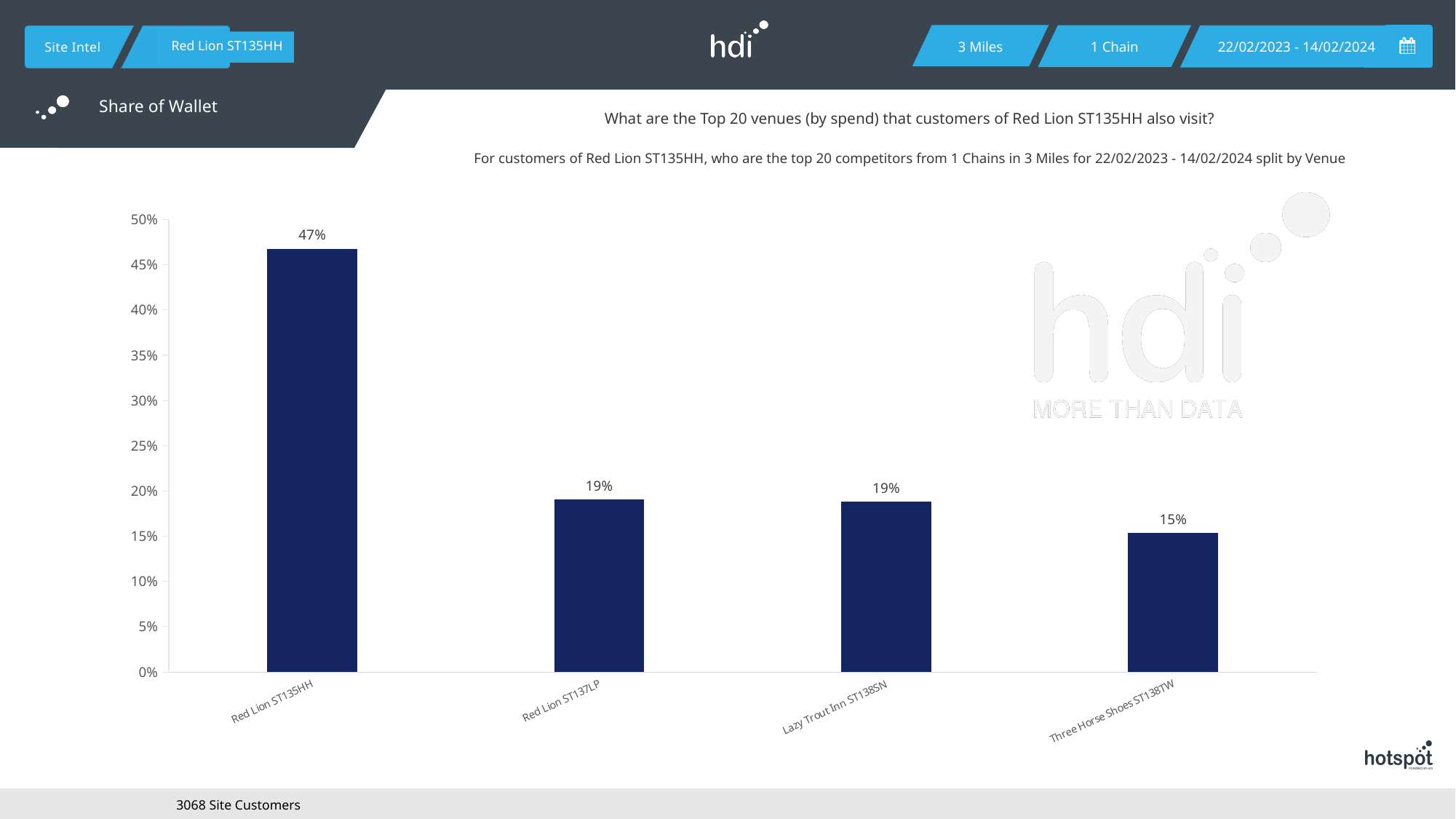
What is the value for Red Lion ST137LP? 19% What is the difference between the values for Red Lion ST135HH and Red Lion ST137LP? 28% What is the highest value shown on the y axis? 50% Which is larger, the value for Red Lion ST135HH or the value for Three Horse Shoes ST138TW? Red Lion ST135HH How many venues are shown on the chart? 4 What is the difference between the values for Lazy Trout Inn ST138SN and Three Horse Shoes ST138TW? 4% What is the value for Red Lion ST135HH? 47% What kind of chart is shown on the slide? Bar chart Which venue has the highest value? Red Lion ST135HH What is the value for Lazy Trout Inn ST138SN? 19% What is the value for Three Horse Shoes ST138TW? 15% Which venue has the lowest value? Three Horse Shoes ST138TW